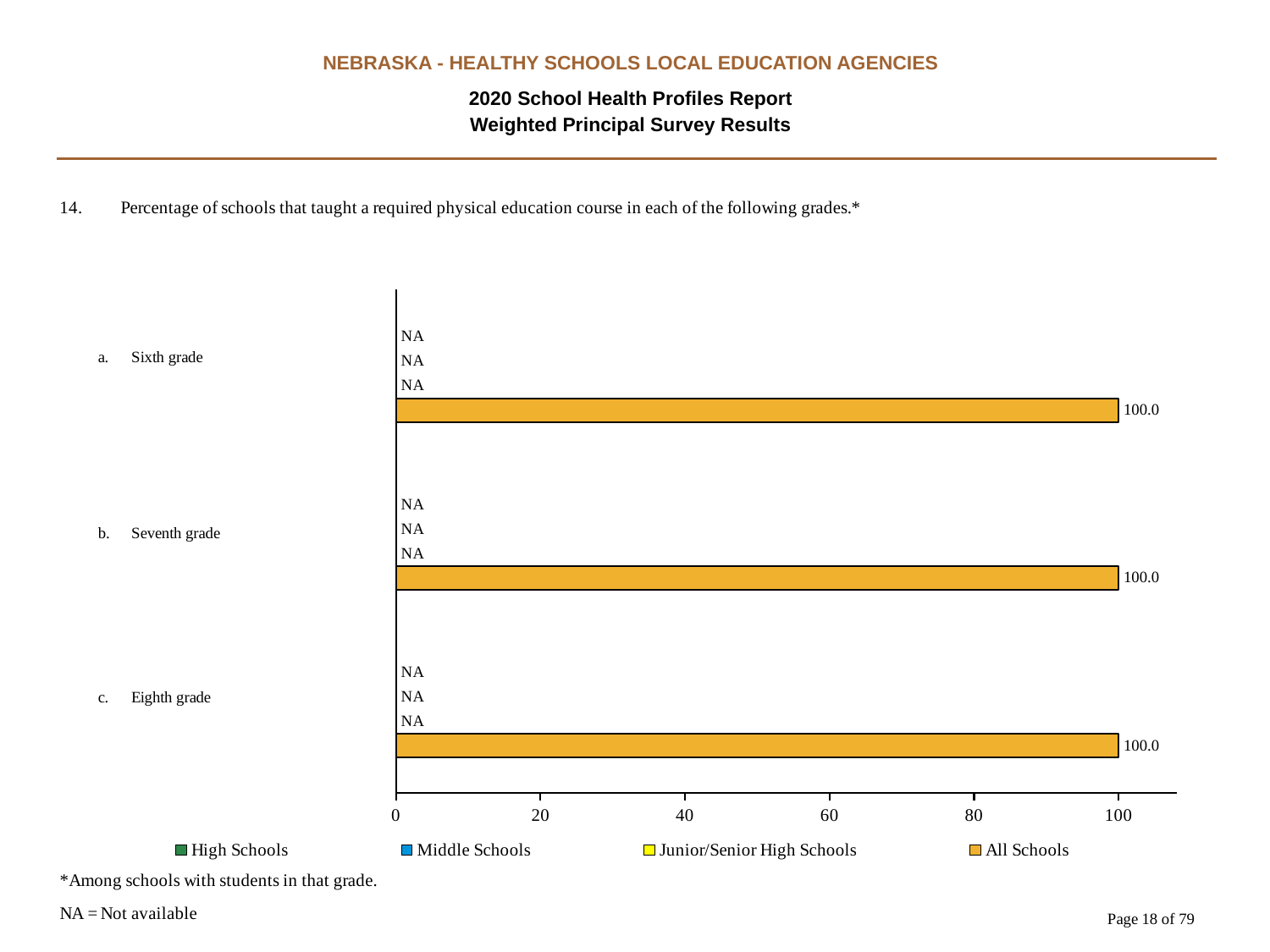
What is the value for All Schools in Seventh grade? 100.0 What is shown for Junior/Senior High Schools in Seventh grade? NA What kind of chart is this? bar chart How many series does the legend list? 4 What is the value for All Schools in Sixth grade? 100.0 How many grade categories are shown on the chart? 3 Is the value for All Schools in Seventh grade greater or less than 80? greater What is shown for Middle Schools in Eighth grade? NA What is the value for All Schools in Eighth grade? 100.0 What is shown for High Schools in Sixth grade? NA Which series is shown in orange in the legend? All Schools What is the difference between the All Schools values for Sixth grade and Eighth grade? 0.0